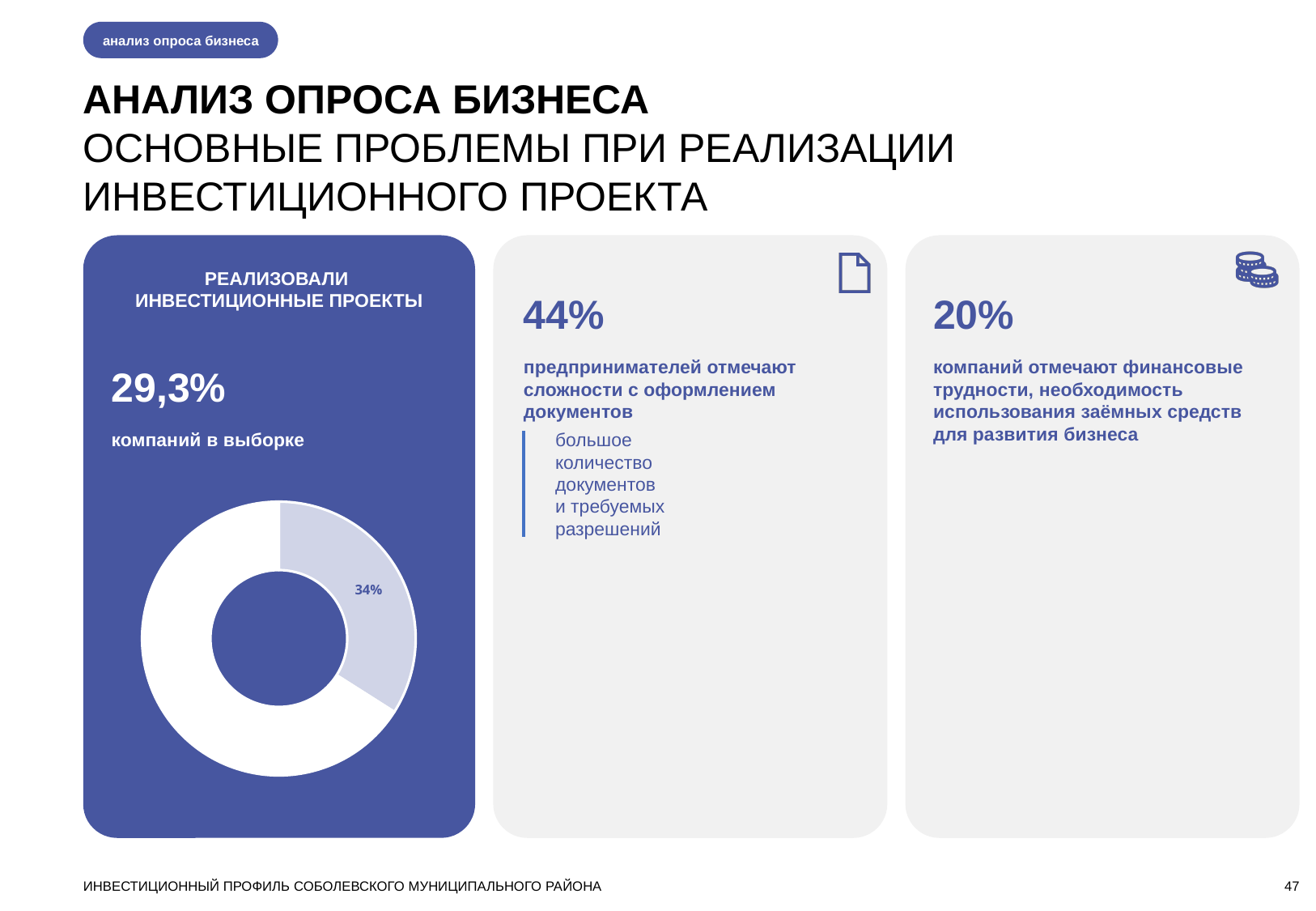
What is the heading printed above the doughnut chart in the left panel? РЕАЛИЗОВАЛИ ИНВЕСТИЦИОННЫЕ ПРОЕКТЫ Does the doughnut chart on the left panel show a legend? No What kind of chart is shown in the left panel under 'РЕАЛИЗОВАЛИ ИНВЕСТИЦИОННЫЕ ПРОЕКТЫ'? doughnut (pie) chart In the doughnut chart on the left panel, is the labelled slice's share greater or less than 50%? less In the doughnut chart on the left panel, what value is printed on the light-coloured slice? 34% In the doughnut chart on the left panel, which slice is larger: the white slice or the light-coloured slice labelled 34%? the white slice How many slices does the doughnut chart on the left panel have? 2